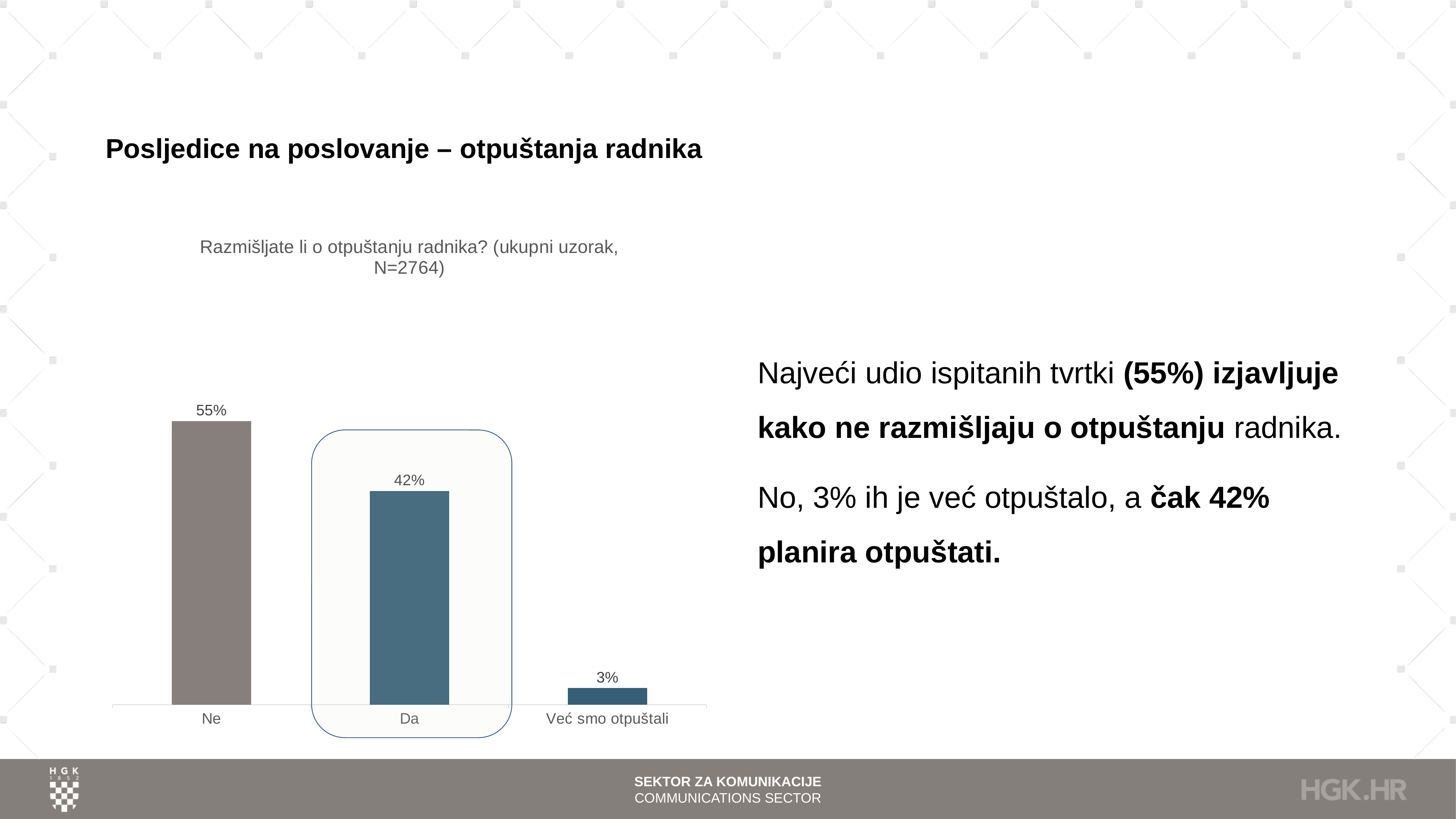
What is the difference between the values for "Ne" and "Da"? 13% Which category has the highest value? Ne What is the value for "Već smo otpuštali"? 3% What is the value for "Ne"? 55% What is the sample size (N) stated in the chart title? 2764 What is the value for "Da"? 42% How many categories are shown on the x axis? 3 What is the difference between the values for "Da" and "Već smo otpuštali"? 39% Which is larger, the value for "Da" or the value for "Već smo otpuštali"? Da Which category has the lowest value? Već smo otpuštali Do the values rise or fall from left to right along the x axis? fall What kind of chart is shown on the slide? bar chart